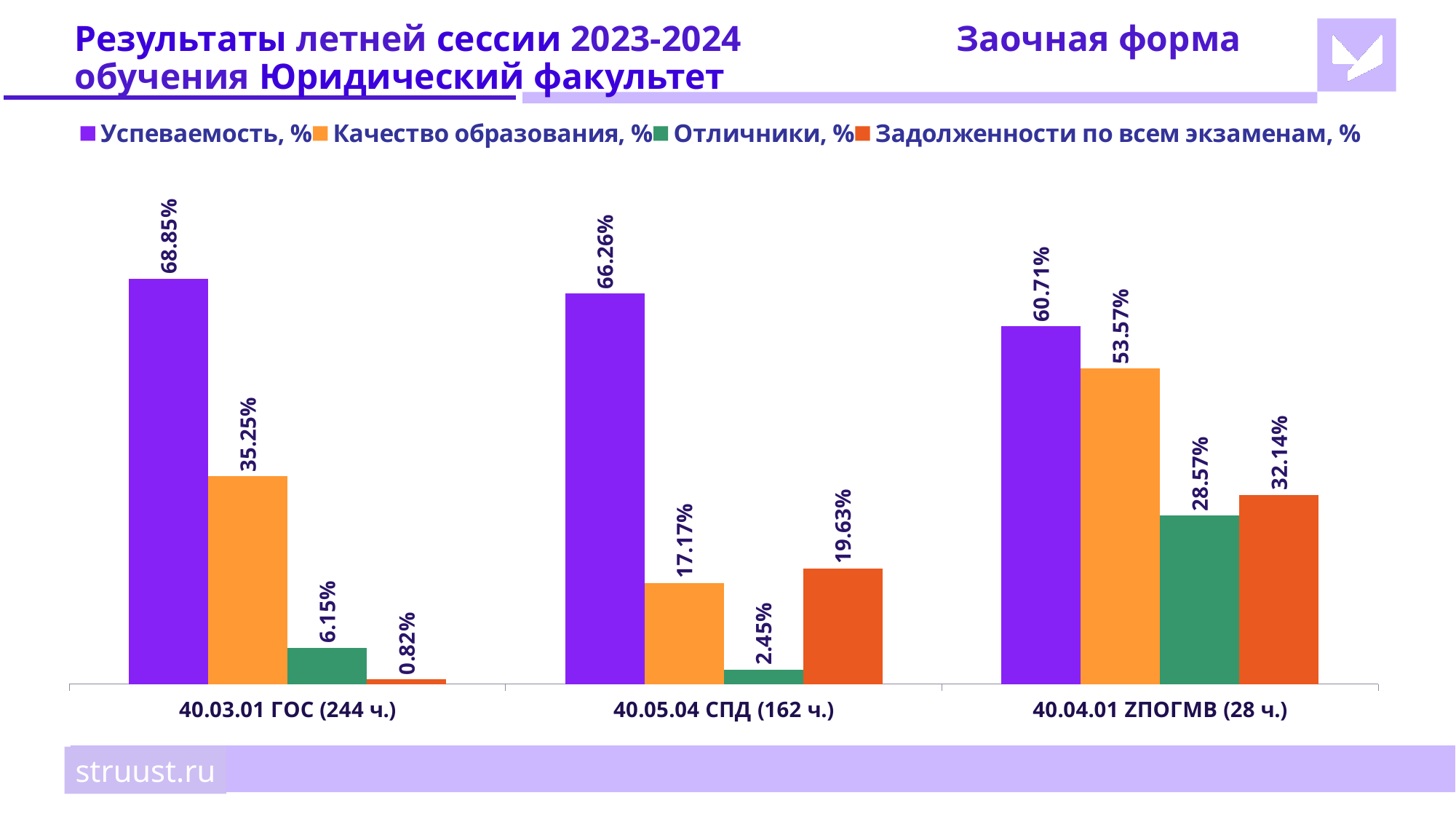
What is the difference between Качество образования, % for 40.04.01 ZПОГМВ (28 ч.) and for 40.03.01 ГОС (244 ч.)? 18.32% What is the value of Отличники, % for 40.03.01 ГОС (244 ч.)? 6.15% What is the value of Успеваемость, % for 40.03.01 ГОС (244 ч.)? 68.85% What is the value of Задолженности по всем экзаменам, % for 40.05.04 СПД (162 ч.)? 19.63% What is the difference between Успеваемость, % for 40.03.01 ГОС (244 ч.) and for 40.05.04 СПД (162 ч.)? 2.59% Which category has the highest value of Успеваемость, %? 40.03.01 ГОС (244 ч.) Which category has the lowest value of Задолженности по всем экзаменам, %? 40.03.01 ГОС (244 ч.) How many categories are shown on the x axis? 3 How many series does the legend list? 4 What kind of chart is shown on the slide? Bar chart What is the value of Качество образования, % for 40.04.01 ZПОГМВ (28 ч.)? 53.57% Which is larger for 40.05.04 СПД (162 ч.): Качество образования, % or Задолженности по всем экзаменам, %? Задолженности по всем экзаменам, %